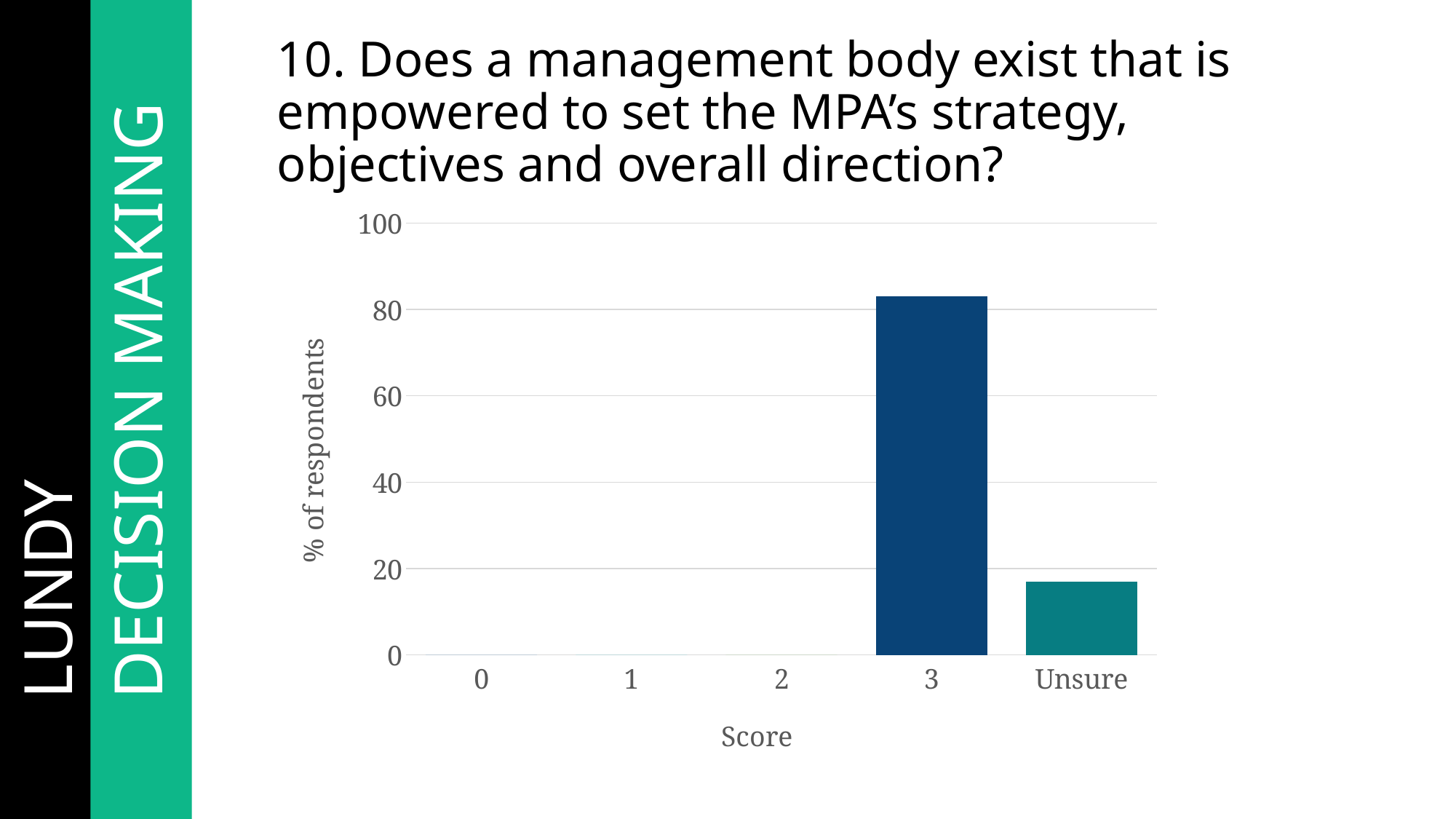
Is the value for Unsure greater or less than 20? less Is the value for score 3 greater or less than 60? greater Is the value for score 3 greater or less than 80? greater What is the label of the x axis of the chart? Score What kind of chart is shown on the slide? bar chart Which is larger, the value for score 3 or the value for Unsure? 3 What is the label of the y axis of the chart? % of respondents How many categories are shown on the x axis of the chart? 5 What is the highest value shown on the y axis of the chart? 100 Which score category has the highest percentage of respondents? 3